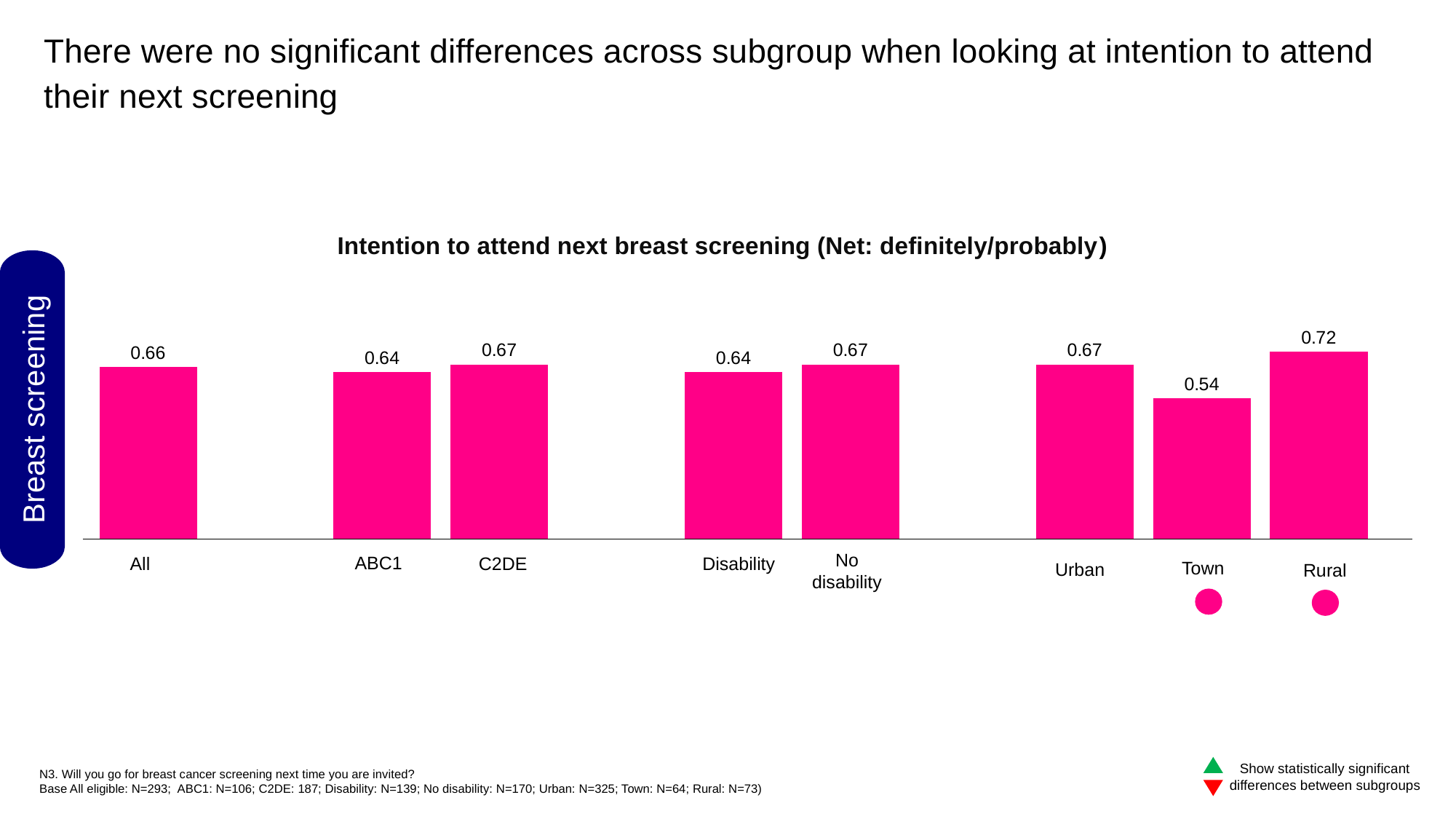
What kind of chart is shown? Bar chart What is the value for Town? 0.54 What is the difference between the values for C2DE and ABC1? 0.03 Which category has the lowest value? Town Which is larger, the value for Urban or the value for Town? Urban What is the title of the chart? Intention to attend next breast screening (Net: definitely/probably) What is the value for ABC1? 0.64 What is the difference between the values for Rural and Town? 0.18 How many bars are plotted in the chart? 8 What is the value for Rural? 0.72 Which category has the highest value? Rural What is the value for All? 0.66